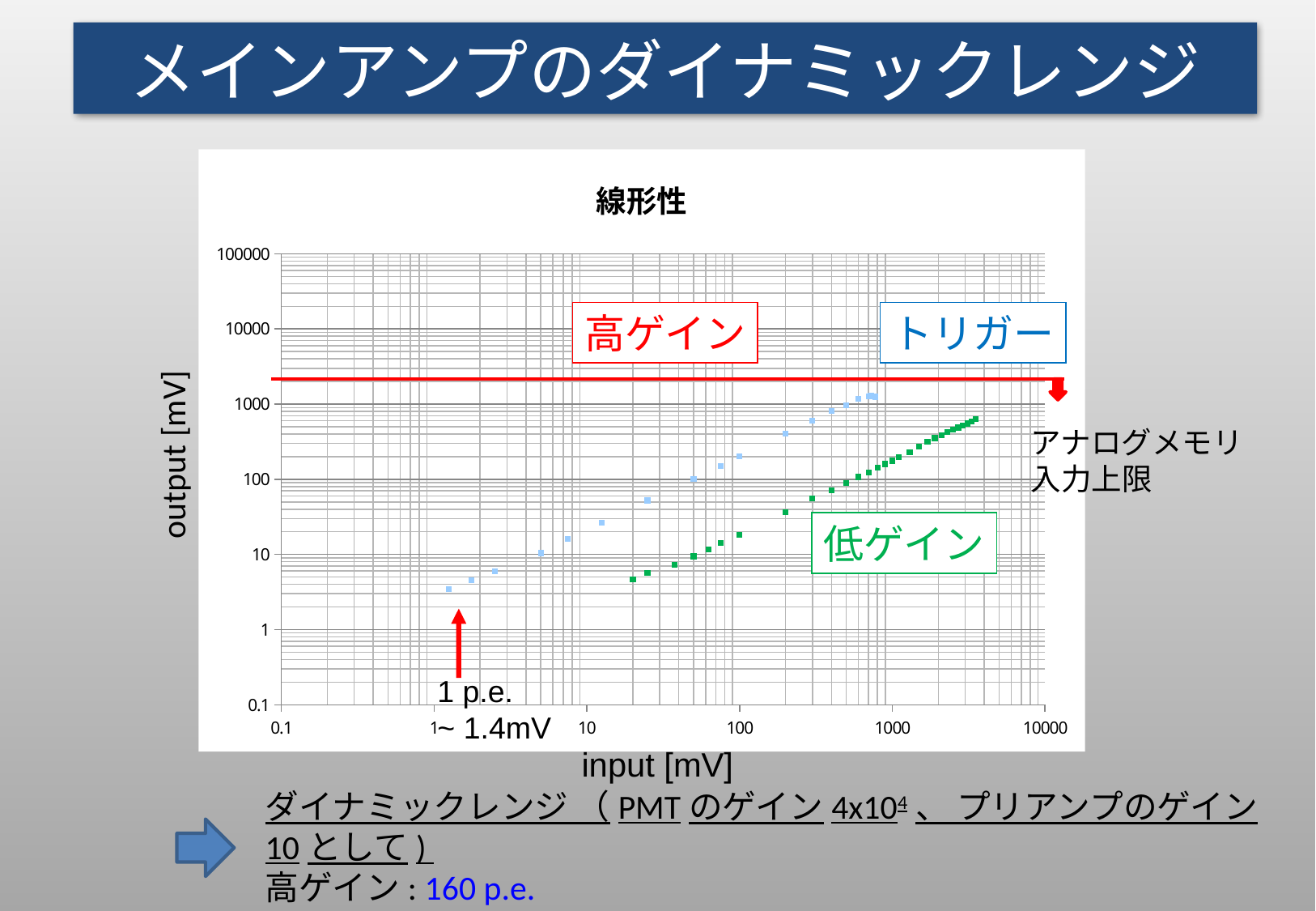
What is the title of the chart? 線形性 At an input of 100 mV, which series has the larger output, 高ゲイン or 低ゲイン? 高ゲイン Is the output of the 低ゲイン series at an input of 3000 mV greater or less than 100? greater What is the label of the y axis of the chart? output [mV] What kind of chart is shown on the slide? scatter chart What is the largest tick value shown on the x axis of the chart? 10000 How many data series are plotted in the chart? 2 Is the output of the 低ゲイン series at an input of 100 mV greater or less than 100? less Do the output values of the 低ゲイン series rise or fall as input increases? rise Is the output of the 高ゲイン series at an input of 100 mV greater or less than 100? greater